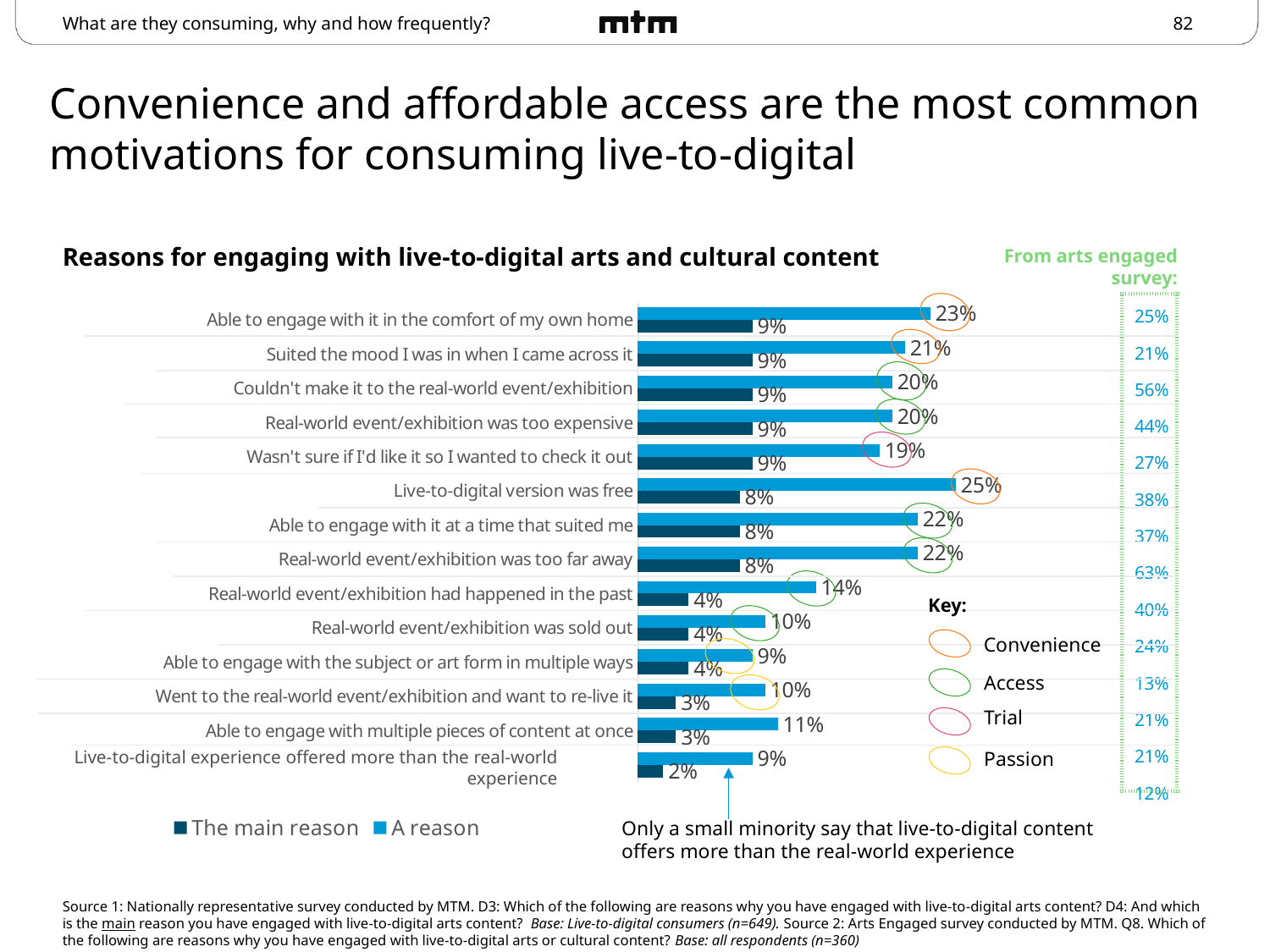
What type of chart is used to show the reasons for engaging with live-to-digital arts and cultural content? Bar chart Which has a larger 'A reason' value: 'Real-world event/exhibition was too far away' or 'Real-world event/exhibition was sold out'? Real-world event/exhibition was too far away How many series does the chart legend list? 2 What percentage gave 'Able to engage with it in the comfort of my own home' as the main reason? 9% What is the difference between the 'A reason' value for 'Live-to-digital version was free' and for 'Real-world event/exhibition had happened in the past'? 11% What is 'The main reason' value for 'Went to the real-world event/exhibition and want to re-live it'? 3% Which reason has the highest value for the 'A reason' series? Live-to-digital version was free What are the two series named in the chart legend? The main reason; A reason How many reasons (categories) are plotted in the chart? 14 What is the 'A reason' value for 'Able to engage with multiple pieces of content at once'? 11% Which reason has the lowest value for 'The main reason' series? Live-to-digital experience offered more than the real-world experience What percentage gave 'Live-to-digital version was free' as a reason? 25%